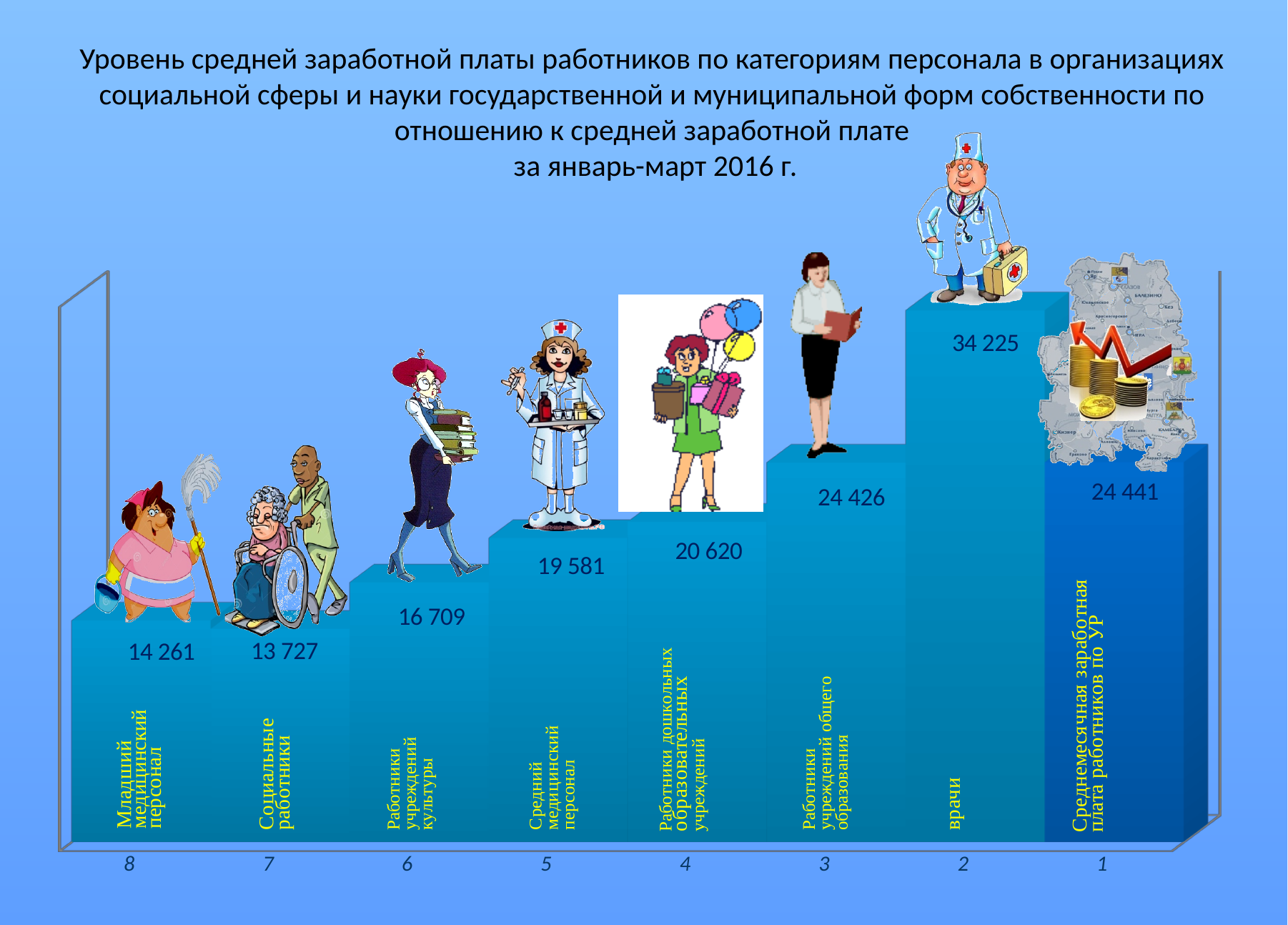
What is the difference between the values for врачи and Младший медицинский персонал? 19 964 What kind of chart is shown on the slide? bar chart What is the difference between the values for Работники дошкольных образовательных учреждений and Средний медицинский персонал? 1 039 How many categories are shown in the chart? 8 What is the value shown for врачи? 34 225 What is the value shown for Среднемесячная заработная плата работников по УР? 24 441 Which is larger: the value for Работники учреждений общего образования or the value for Работники учреждений культуры? Работники учреждений общего образования What is the value shown for Социальные работники? 13 727 Which category has the highest value? врачи What period does the chart title say the data covers? январь-март 2016 г. What is the value shown for Работники учреждений культуры? 16 709 Which category has the lowest value? Социальные работники